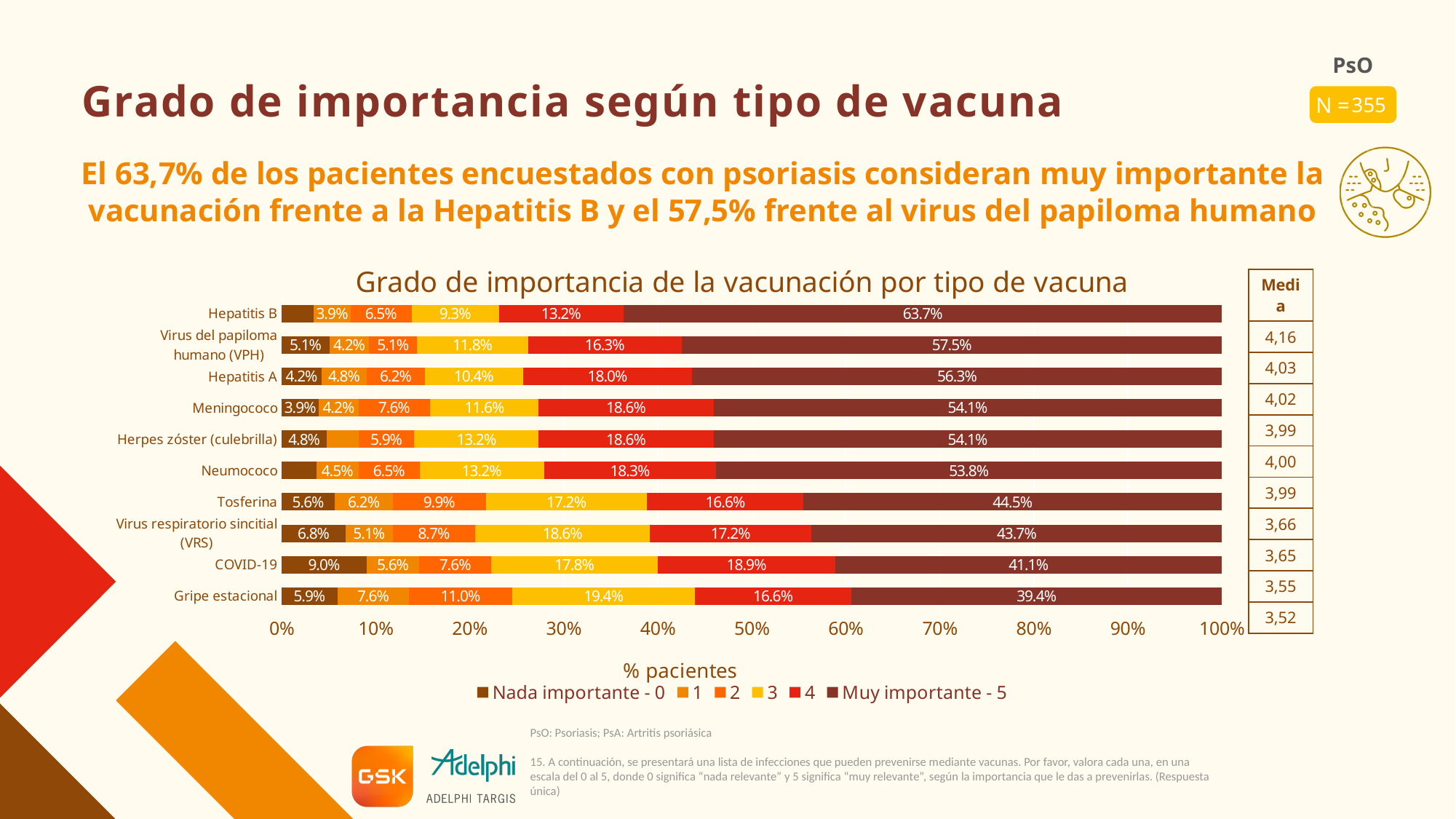
How many series does the legend list? 6 What is the value of series '4' for Hepatitis A? 18.0% Which vaccine has the lowest 'Muy importante - 5' percentage? Gripe estacional Which vaccine has the highest 'Nada importante - 0' percentage? COVID-19 What is the difference in percentage points between the 'Muy importante - 5' values for Hepatitis B and Virus del papiloma humano (VPH)? 6.2 percentage points What is the 'Nada importante - 0' value for COVID-19? 9.0% What is the 'Muy importante - 5' value for Gripe estacional? 39.4% Which vaccine has the highest 'Muy importante - 5' percentage? Hepatitis B What kind of chart is shown on the slide? Stacked bar chart Which has a larger 'Muy importante - 5' value, COVID-19 or Tosferina? Tosferina How many vaccine types are shown in the chart? 10 What percentage of patients rated Hepatitis B vaccination as 'Muy importante - 5'? 63.7%